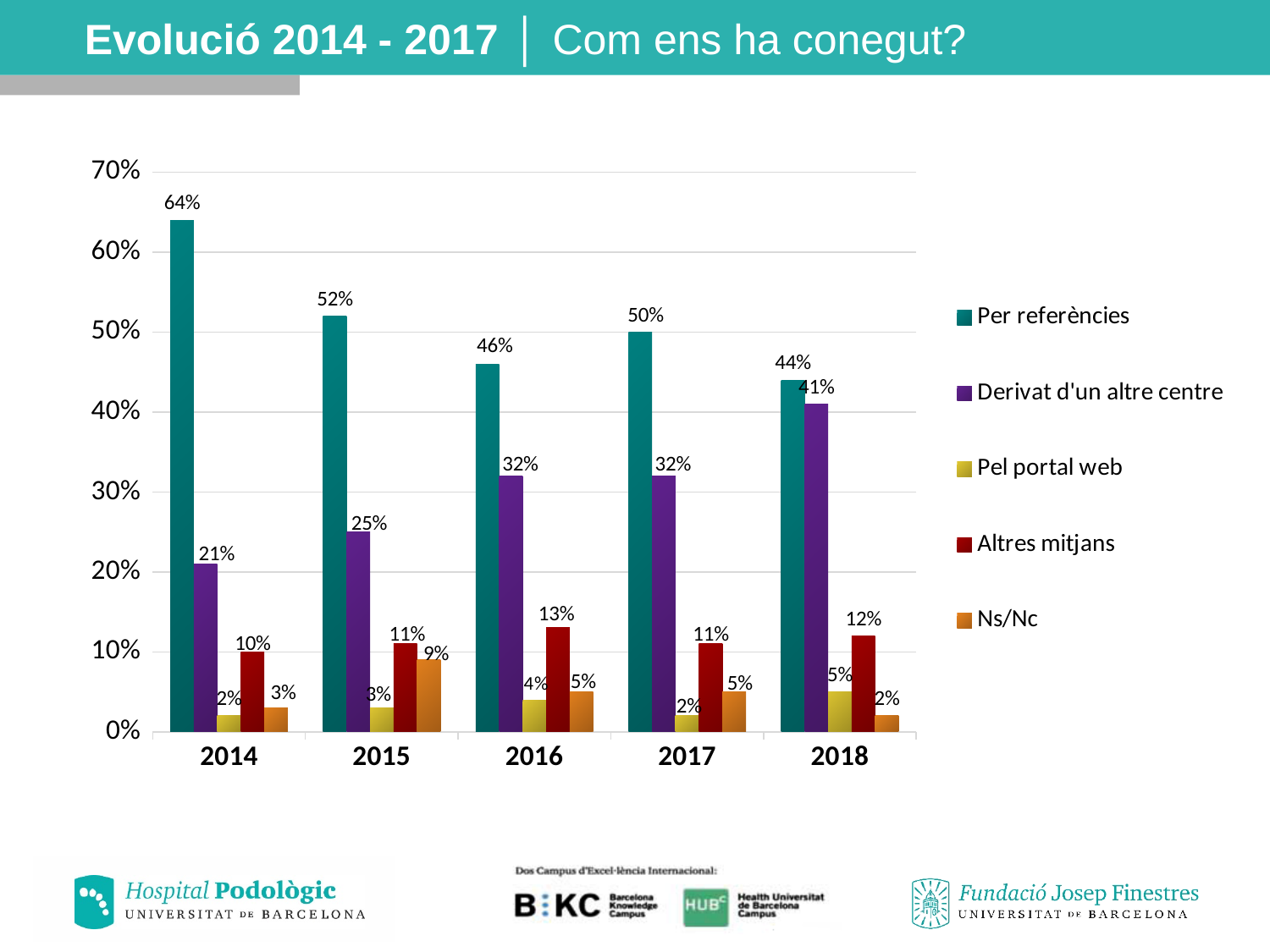
What kind of chart is shown on the slide? Bar chart What is the difference between 'Per referències' and 'Derivat d'un altre centre' in 2018? 3% What is the value for 'Altres mitjans' in 2016? 13% How many years are shown on the x axis? 5 Does 'Per referències' rise or fall from 2014 to 2016? Fall What is the value for 'Derivat d'un altre centre' in 2018? 41% Which is larger in 2017: 'Altres mitjans' or 'Ns/Nc'? Altres mitjans What is the value for 'Ns/Nc' in 2015? 9% In which year is 'Derivat d'un altre centre' lowest? 2014 In which year is 'Per referències' highest? 2014 How many series does the legend list? 5 What is the value for 'Per referències' in 2014? 64%